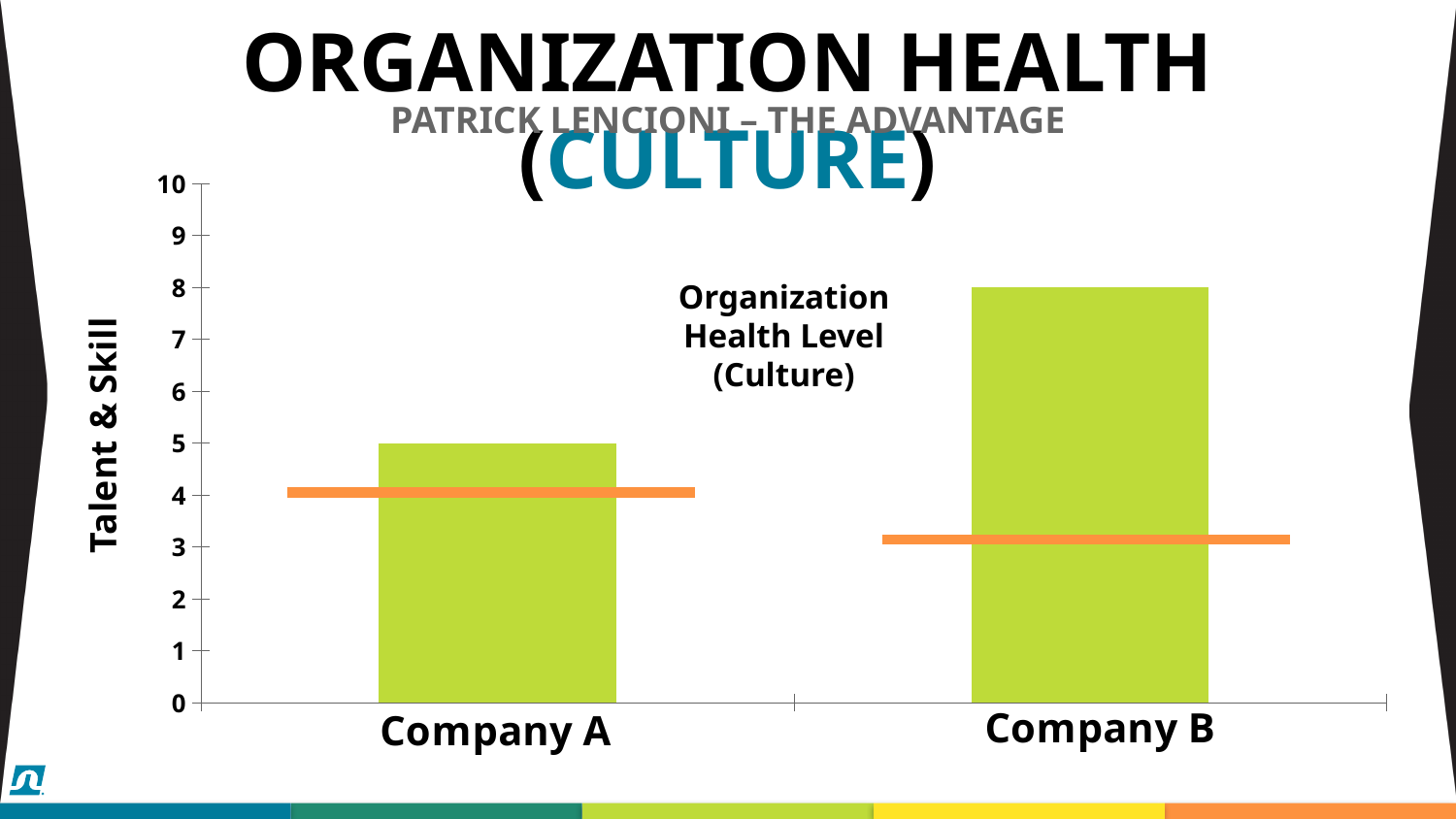
What is the value of the green bar for Company A? 5 Which company has the shorter green bar? Company A What is the label on the vertical axis? Talent & Skill What is the value of the green bar for Company B? 8 Is the orange line for Company B greater or less than 4? less What kind of chart is shown on the slide? bar chart Is the green bar for Company A or Company B larger? Company B Is the orange line for Company A greater or less than 3? greater Which company has the taller green bar? Company B Is the green bar for Company B greater or less than 7? greater What is the difference between the green bar values for Company B and Company A? 3 How many companies are shown on the x axis? 2